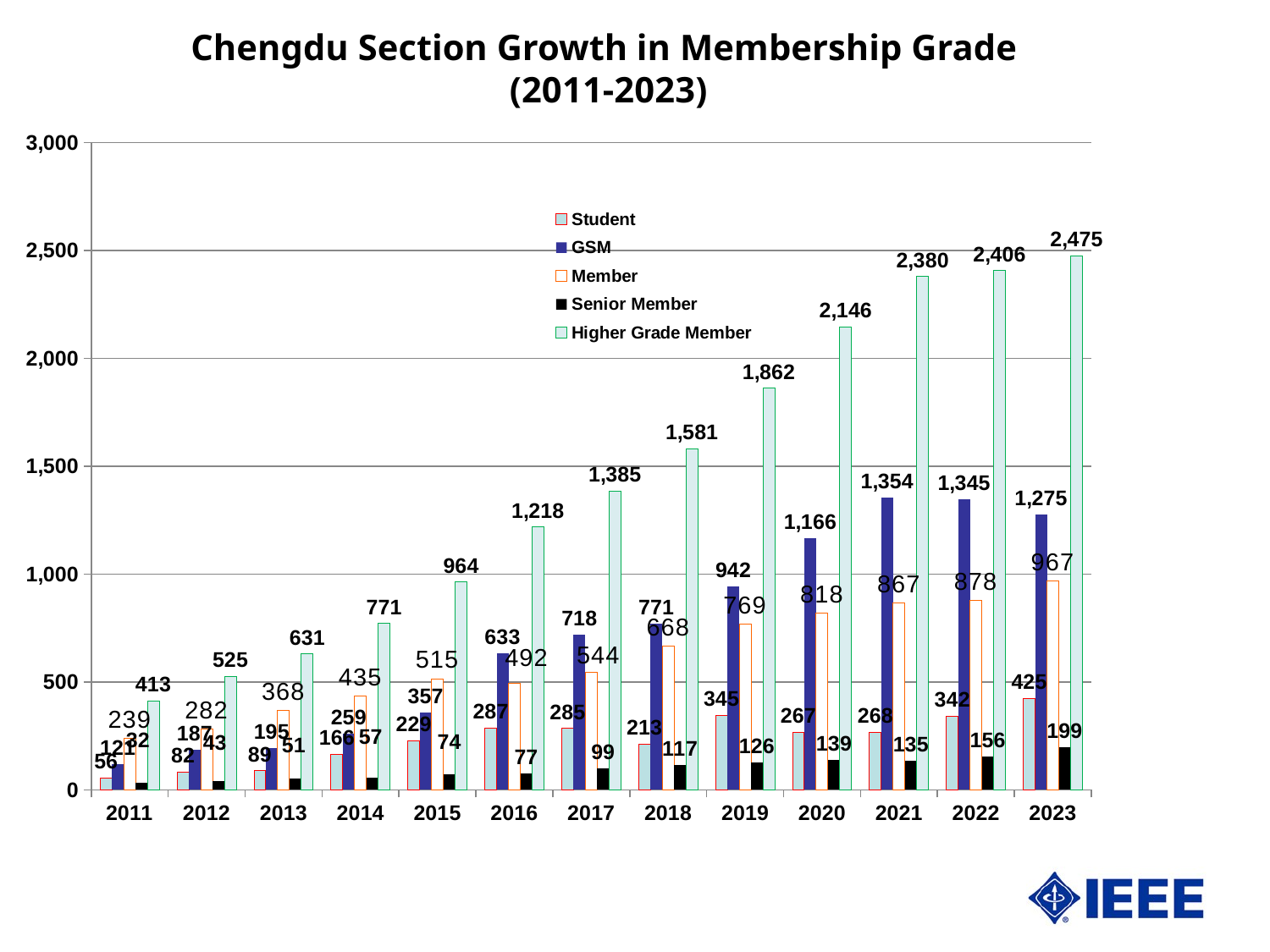
What is the value for GSM in 2020? 1,166 What is the value for Senior Member in 2022? 156 What is the value for Member in 2019? 769 How many years are shown on the x axis? 13 Which is larger, the GSM value in 2021 or the GSM value in 2023? 2021 What is the value for Higher Grade Member in 2023? 2,475 What kind of chart is shown on the slide? bar chart In which year is the Higher Grade Member value lowest? 2011 What is the difference between the Higher Grade Member values in 2022 and 2021? 26 In which year is the Student value highest? 2023 How many series does the legend list? 5 Is the Member value in 2023 greater or less than 1,000? less